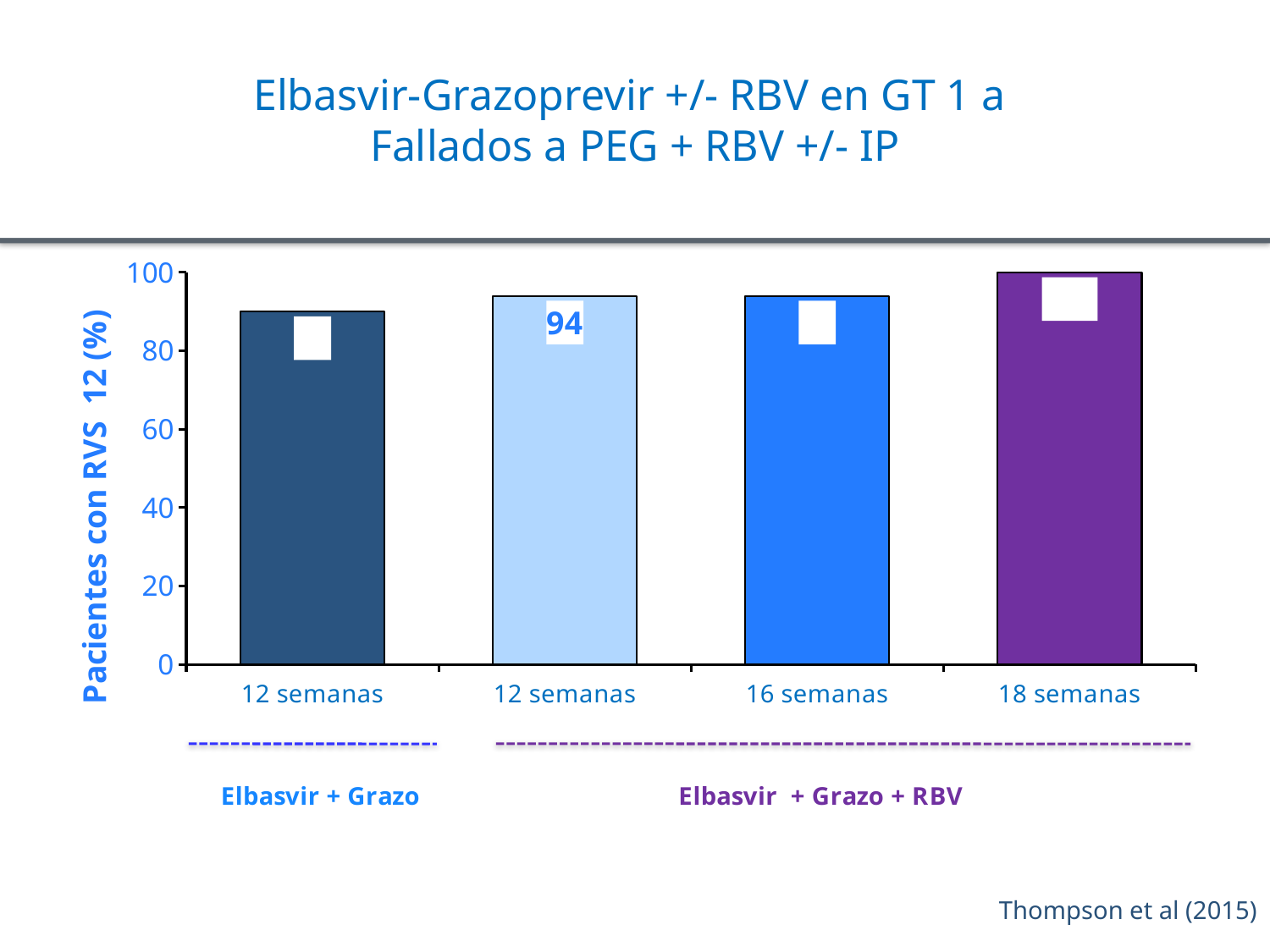
What kind of chart is shown on the slide? bar chart Is the value for 18 semanas greater or less than 80? greater Is the value for the 12 semanas bar in the Elbasvir + Grazo group greater or less than 100? less Is the value for 16 semanas greater or less than 80? greater How many bars are shown in the chart? 4 Which is larger: the value for 18 semanas or the value for 12 semanas in the Elbasvir + Grazo group? 18 semanas Which treatment group do the 16 semanas and 18 semanas bars belong to? Elbasvir + Grazo + RBV Which bar has the highest value? 18 semanas What is the value for the 12 semanas bar in the Elbasvir + Grazo + RBV group? 94 What is the label of the y axis? Pacientes con RVS 12 (%)